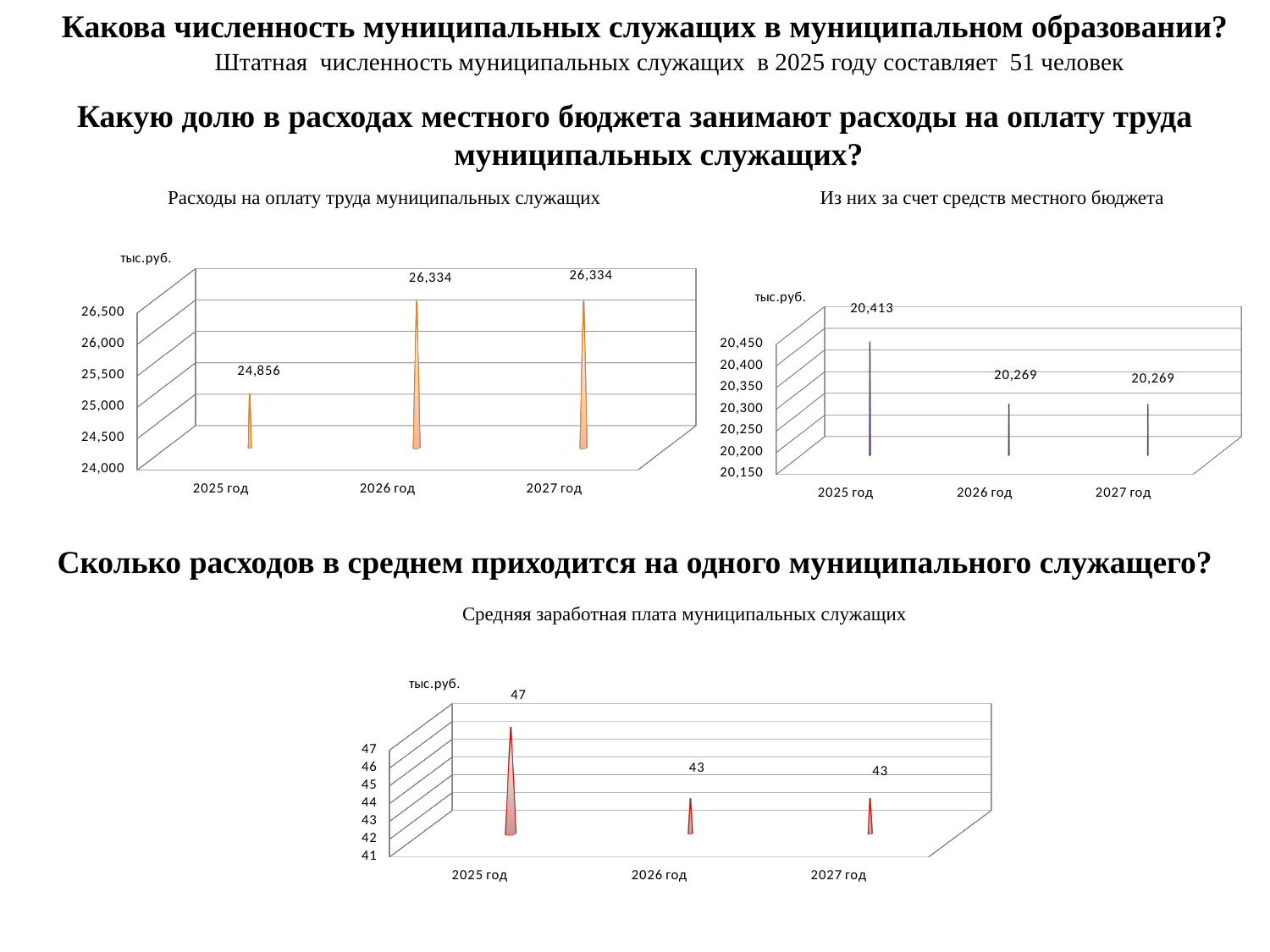
In the chart 'Из них за счет средств местного бюджета', what is the difference between the values for 2025 год and 2026 год? 144 In the chart 'Из них за счет средств местного бюджета', what is the value for 2025 год? 20,413 In the chart 'Из них за счет средств местного бюджета', which year has the highest value? 2025 год In the chart 'Из них за счет средств местного бюджета', what is the value for 2027 год? 20,269 In the chart 'Расходы на оплату труда муниципальных служащих', what is the difference between the values for 2026 год and 2025 год? 1,478 What unit is shown on the vertical axis of the chart 'Расходы на оплату труда муниципальных служащих'? тыс.руб. In the chart 'Средняя заработная плата муниципальных служащих', which is larger, the value for 2025 год or 2026 год? 2025 год In the chart 'Расходы на оплату труда муниципальных служащих', what is the value for 2026 год? 26,334 In the chart 'Средняя заработная плата муниципальных служащих', what is the value for 2025 год? 47 How many categories are shown on the x axis of the chart 'Средняя заработная плата муниципальных служащих'? 3 In the chart 'Расходы на оплату труда муниципальных служащих', which year has the lowest value? 2025 год In the chart 'Расходы на оплату труда муниципальных служащих', what is the value for 2025 год? 24,856